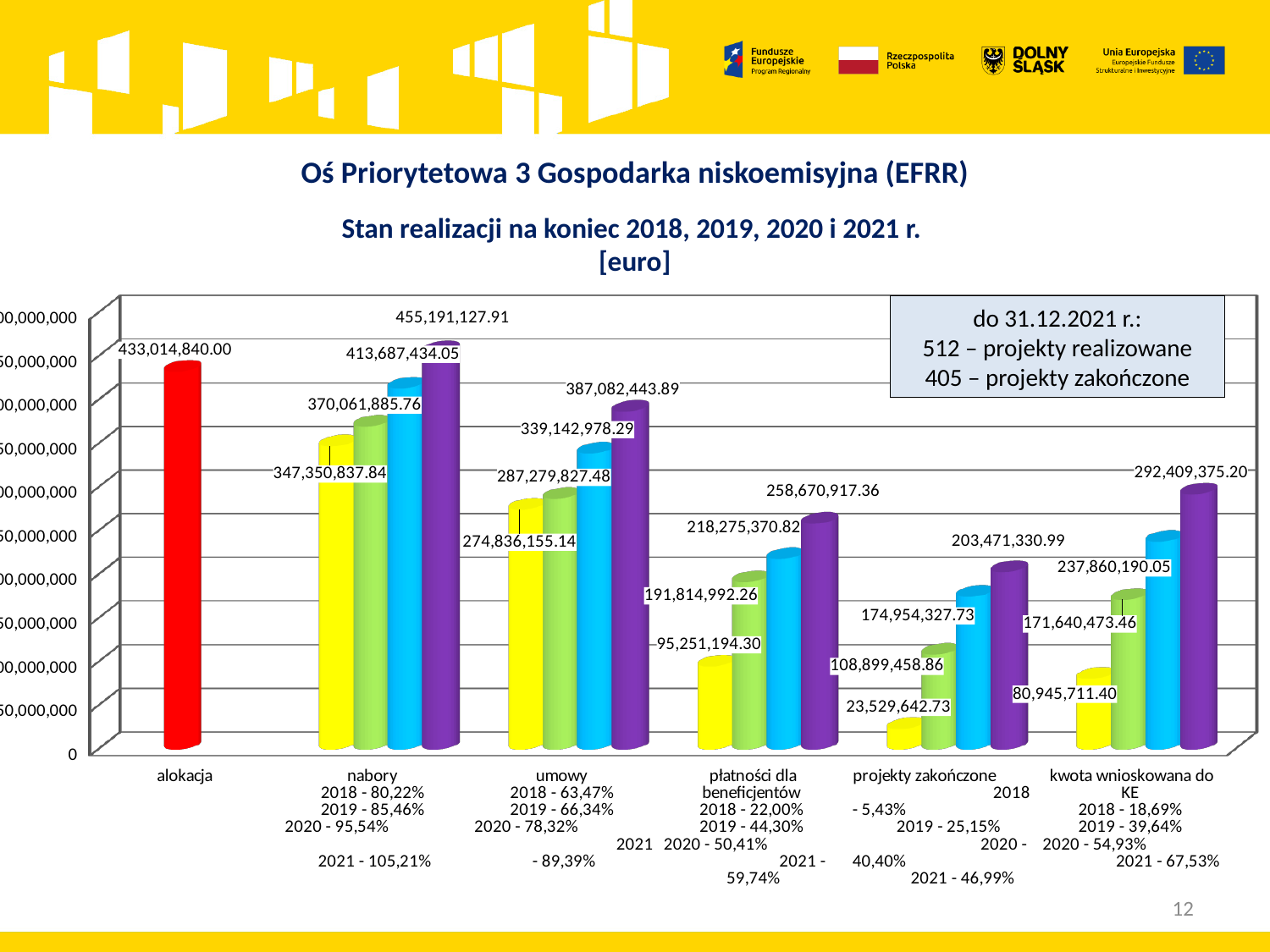
Within the umowy category, do the values rise or fall from 2018 to 2021? rise What is the difference between the 2021 and 2018 values for umowy? 112,246,288.75 What is the 2018 (yellow bar) value for projekty zakończone? 23,529,642.73 Which is larger: the 2021 value for płatności dla beneficjentów or the 2021 value for kwota wnioskowana do KE? kwota wnioskowana do KE What is the 2020 (blue bar) value for kwota wnioskowana do KE? 237,860,190.05 What is the 2021 (purple bar) value for nabory? 455,191,127.91 What is the difference between the 2021 nabory value and the alokacja value? 22,176,287.91 How many categories are shown on the x axis? 6 Which bar has the lowest value on the chart? projekty zakończone 2018 (23,529,642.73) What kind of chart is shown on the slide? bar chart What is the value of the alokacja bar? 433,014,840.00 Which category has the highest single bar on the chart? nabory